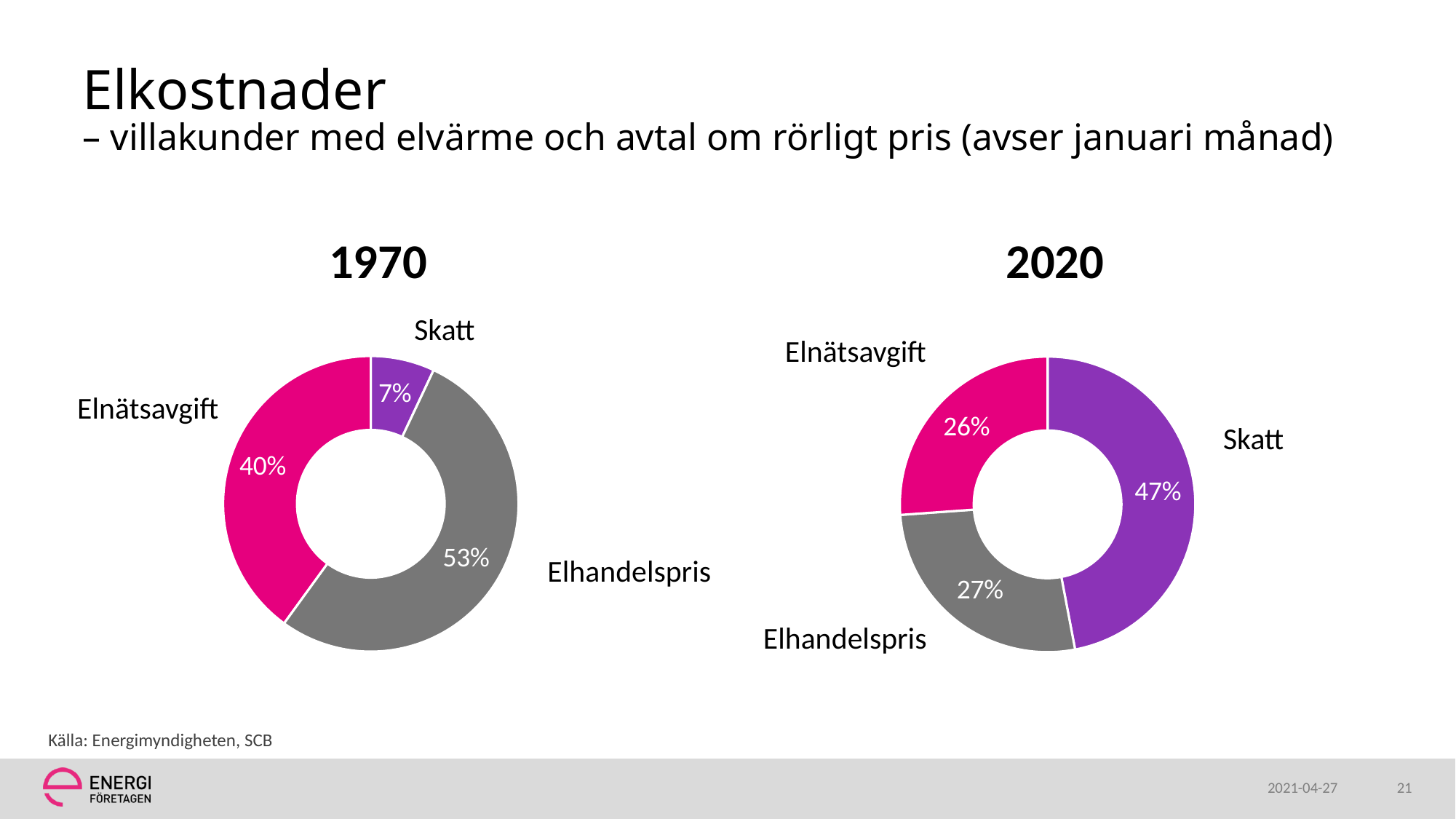
In the 1970 chart, what share does Elhandelspris have? 53% How many categories does the 2020 chart show? 3 In the 1970 chart, which category has the smallest share? Skatt In the 1970 chart, what share does Skatt have? 7% In the 1970 chart, which category has the largest share? Elhandelspris In the 1970 chart, which is larger: Elnätsavgift or Skatt? Elnätsavgift In the 2020 chart, what share does Elnätsavgift have? 26% In the 2020 chart, what share does Skatt have? 47% In the 2020 chart, which category has the smallest share? Elnätsavgift What colour is the Skatt slice in the 2020 chart? Purple In the 2020 chart, what is the difference in percentage points between Skatt and Elhandelspris? 20 percentage points What kind of chart is the 1970 chart? Doughnut chart